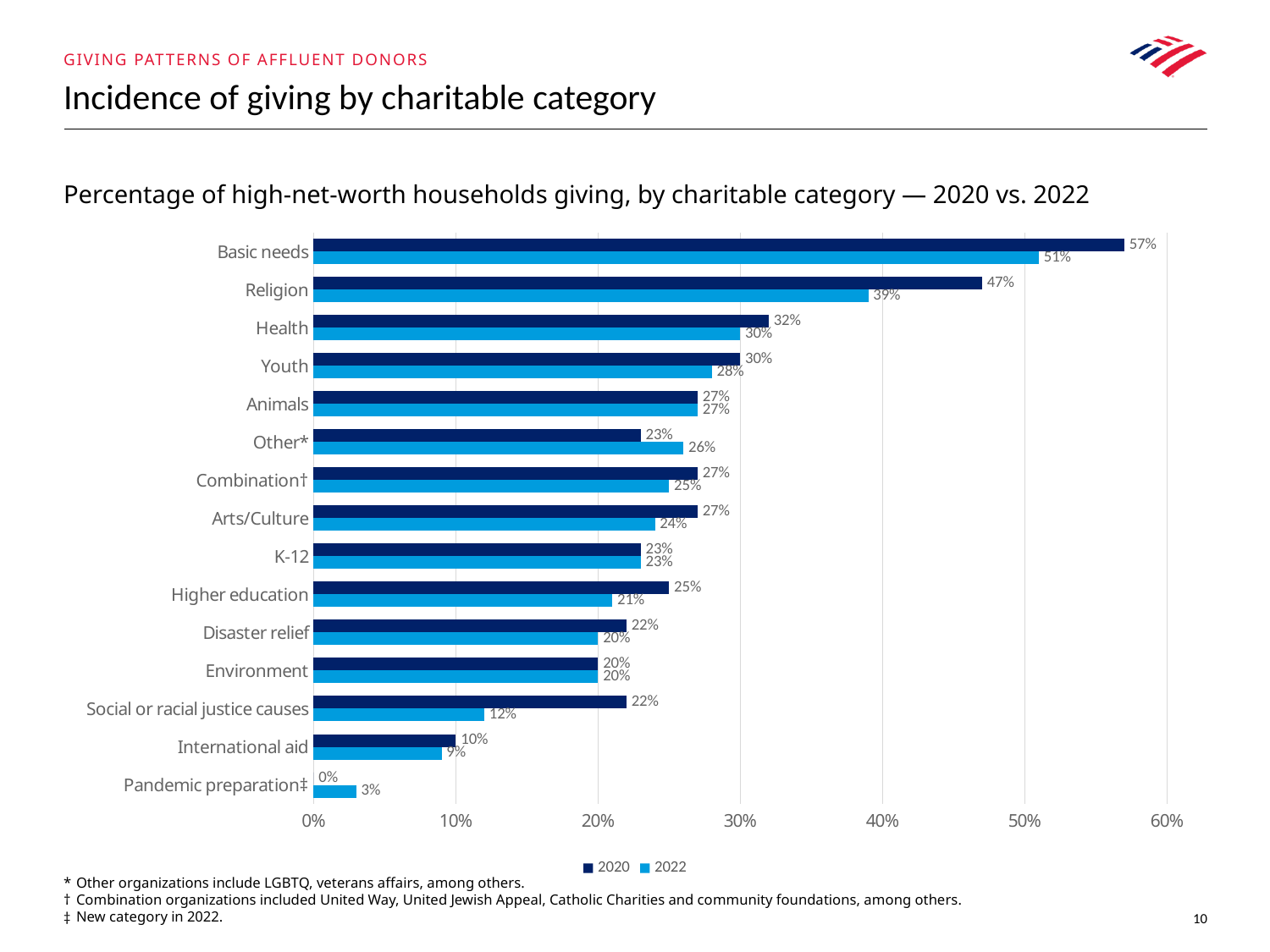
Is the 2020 value for Health greater or less than 30%? greater What kind of chart is shown on the slide? Bar chart What is the difference between the 2020 and 2022 values for Religion? 8% How many series does the legend list? 2 Which is larger for Other*: the 2020 value or the 2022 value? 2022 What was the 2022 value for Social or racial justice causes? 12% How many charitable categories are shown on the chart? 15 What percentage of high-net-worth households gave to Basic needs in 2022? 51% Which charitable category has the highest 2020 value? Basic needs Which charitable category has the lowest 2022 value? Pandemic preparation‡ What is the difference between the 2020 and 2022 values for Social or racial justice causes? 10% What was the 2020 value for Religion? 47%